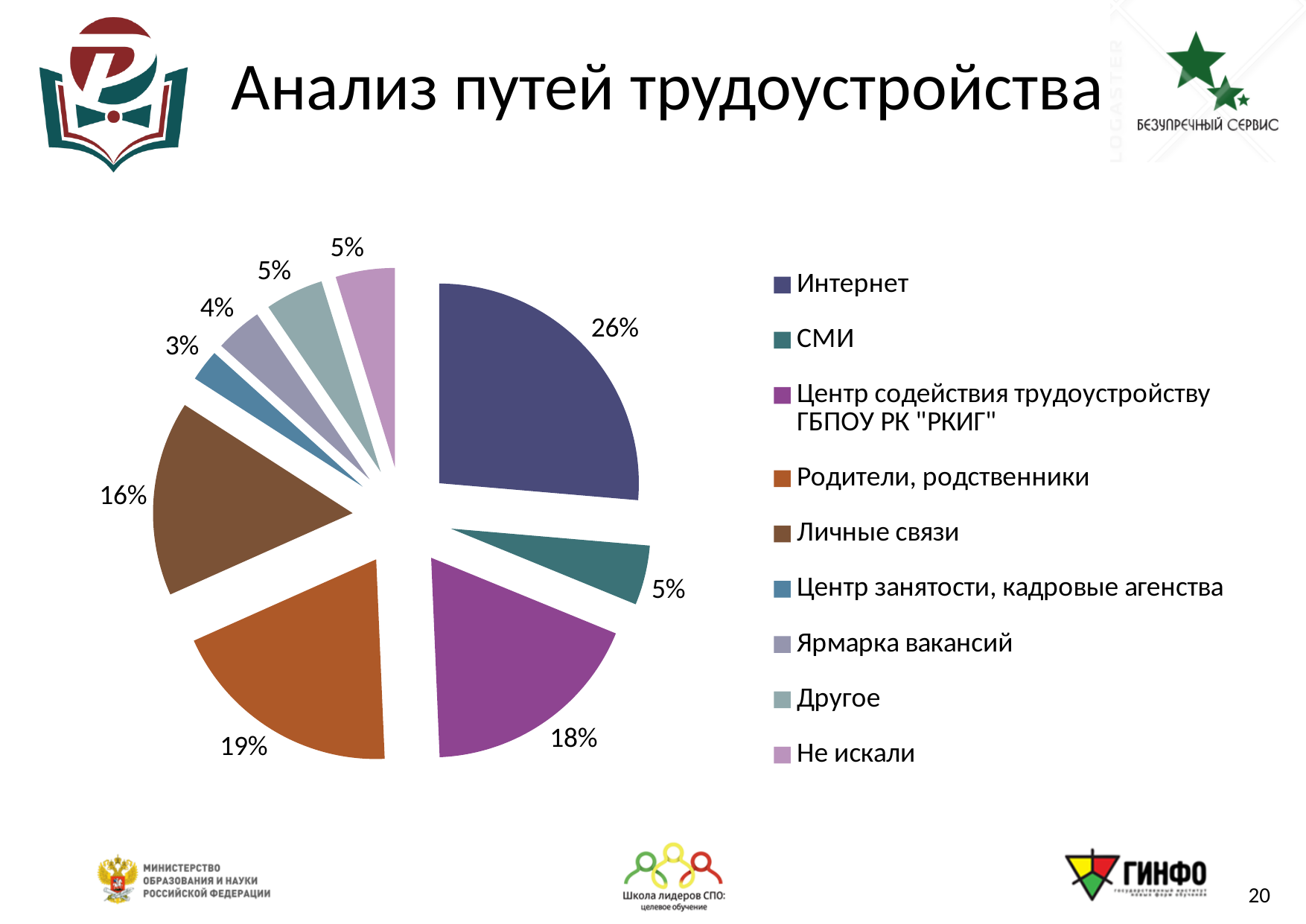
Which category has the smallest share of the pie? Центр занятости, кадровые агенства Which category has the largest share of the pie? Интернет Which is larger, the share for Личные связи or the share for Центр содействия трудоустройству ГБПОУ РК "РКИГ"? Центр содействия трудоустройству ГБПОУ РК "РКИГ" What is the difference between the shares of Интернет and Родители, родственники? 7% What is the value for Личные связи? 16% What kind of chart is shown on the slide? pie chart What is the value for Центр содействия трудоустройству ГБПОУ РК "РКИГ"? 18% How many categories does the legend list? 9 What share of the pie does Интернет have? 26% What is the title of the slide containing the chart? Анализ путей трудоустройства What is the value for Ярмарка вакансий? 4% What is the value for Родители, родственники? 19%